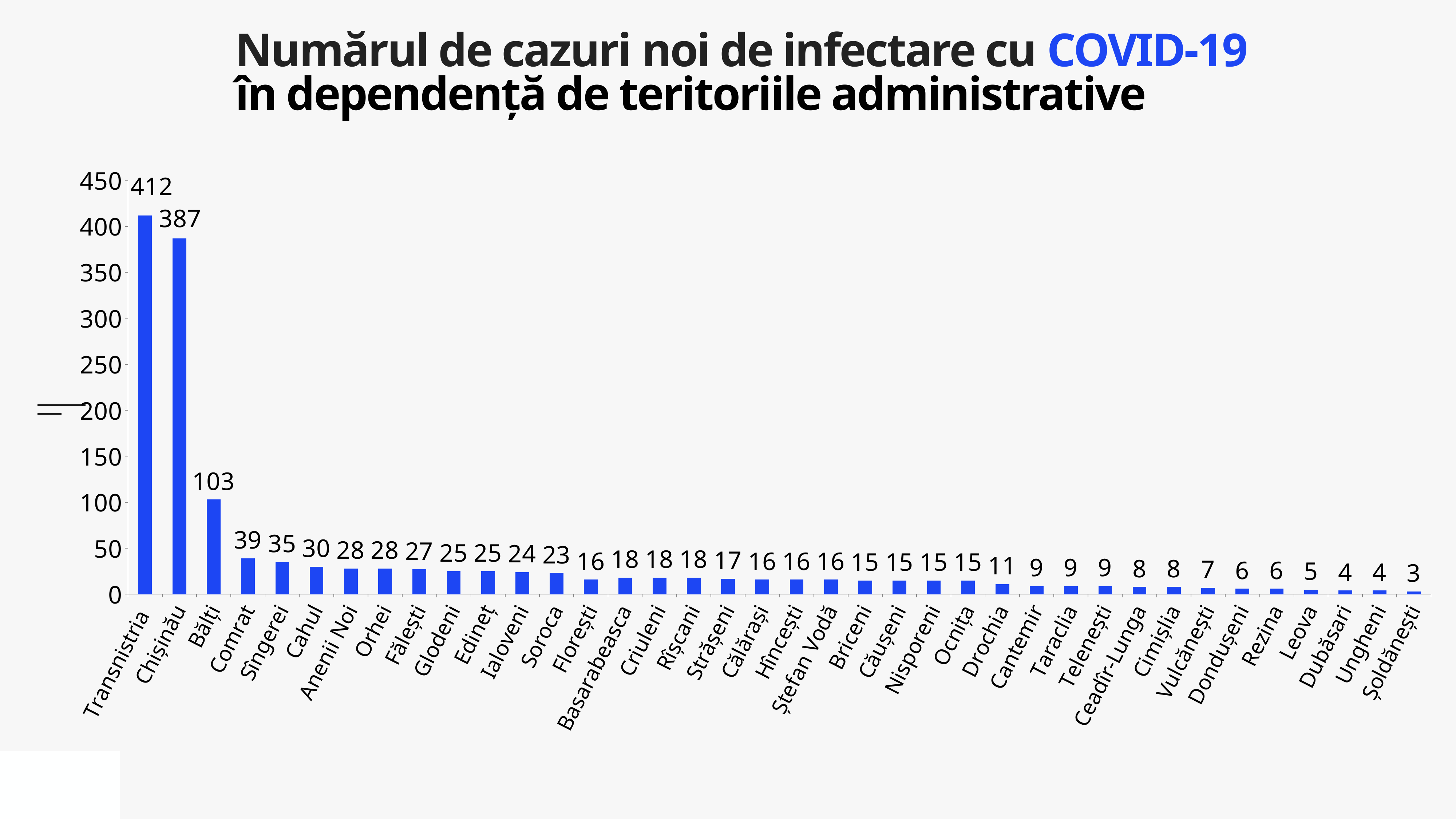
What is the difference between the values for Transnistria and Chișinău? 25 Is the value for Chișinău greater or less than 350? greater Which territory has the lowest number of new cases? Șoldănești What is the value for Bălți? 103 Which territory has the highest number of new cases? Transnistria What is the value for Transnistria? 412 How many territories are shown on the chart? 38 What is the value for Comrat? 39 Which is larger, the value for Bălți or the value for Comrat? Bălți What kind of chart is shown on the slide? bar chart What is the value for Chișinău? 387 Do the values rise or fall from left to right along the x axis? fall